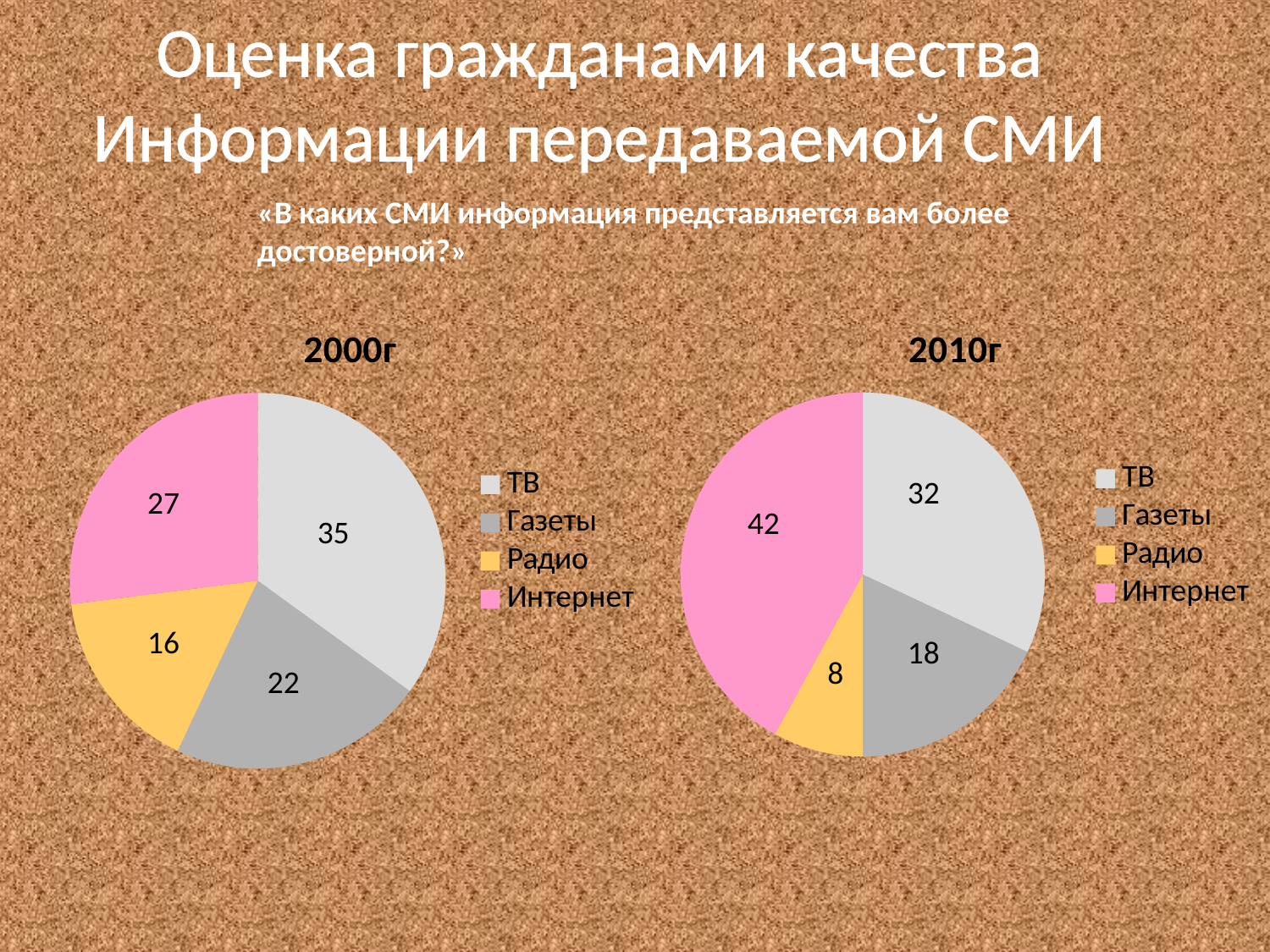
In the 2000г chart, what is the difference between the values for ТВ and Радио? 19 In the 2010г chart, what share of the pie does Интернет take? 42% In the 2000г chart, which category has the largest slice? ТВ In the 2010г chart, what is the value for Радио? 8 In the 2010г chart, which category has the smallest slice? Радио In the 2010г chart, what is the value for Интернет? 42 In the 2000г chart, which is larger, the value for Газеты or the value for Интернет? Интернет How many slices does the 2010г chart have? 4 In the 2000г chart, what is the value for ТВ? 35 What kind of chart is the 2000г chart? pie chart In the 2000г chart, which colour represents Радио? yellow In the 2010г chart, what is the difference between the values for Интернет and Газеты? 24